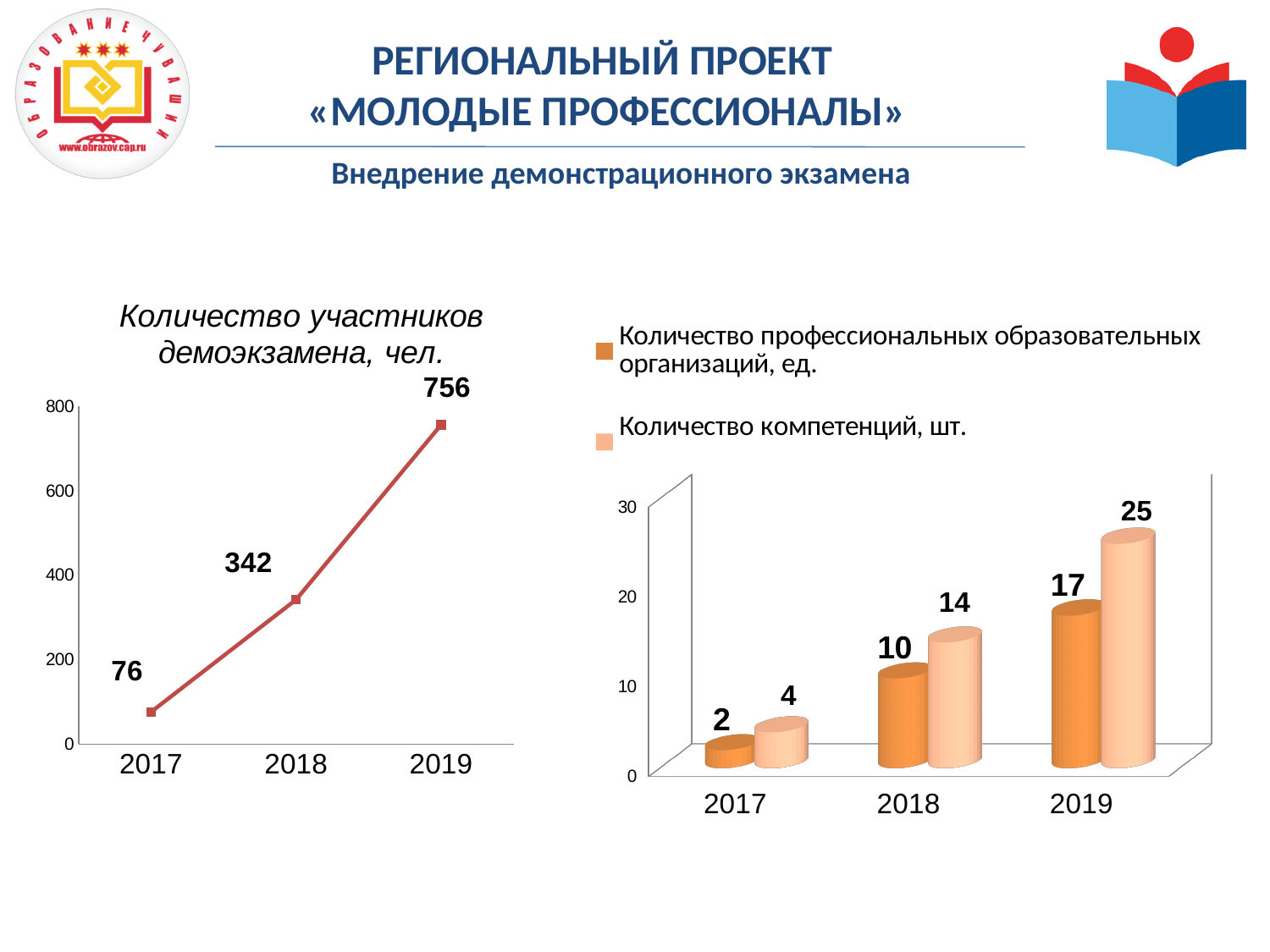
In the right chart, what is the value of 'Количество компетенций, шт.' for 2018? 14 In the left chart 'Количество участников демоэкзамена, чел.', do the values rise or fall from 2017 to 2019? rise How many years are shown on the x axis of the right chart? 3 What kind of chart is the right chart? bar chart In the right chart, how many series does the legend list? 2 In the left chart 'Количество участников демоэкзамена, чел.', what is the value for 2018? 342 In the right chart, which is larger for 2017: 'Количество профессиональных образовательных организаций, ед.' or 'Количество компетенций, шт.'? Количество компетенций, шт. In the left chart 'Количество участников демоэкзамена, чел.', what is the difference between the 2019 and 2017 values? 680 In the left chart 'Количество участников демоэкзамена, чел.', which year has the highest value? 2019 What kind of chart is the left chart 'Количество участников демоэкзамена, чел.'? line chart In the right chart, what is the value of 'Количество профессиональных образовательных организаций, ед.' for 2019? 17 In the right chart, what is the difference between 'Количество компетенций, шт.' and 'Количество профессиональных образовательных организаций, ед.' in 2019? 8